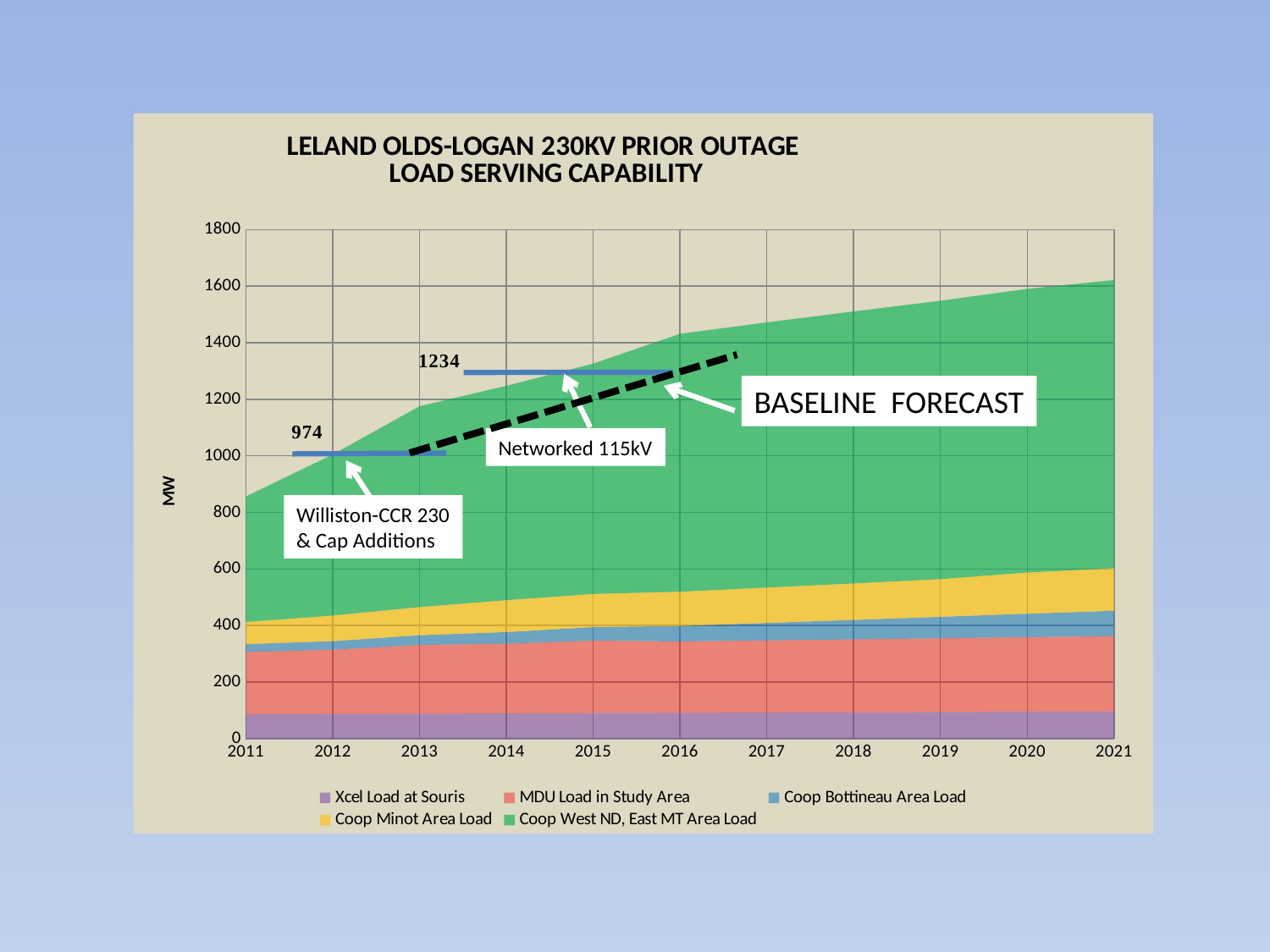
What kind of chart is shown on the slide? Area chart Does the total stacked load rise or fall from 2011 to 2021? Rise Is the total stacked load in 2021 greater or less than 1400 MW? greater What value is labelled on the Williston-CCR 230 & Cap Additions line? 974 Is the total stacked load in 2011 greater or less than 1000 MW? less How many series does the legend list? 5 What is the difference between the Networked 115kV value (1234) and the Williston-CCR 230 & Cap Additions value (974)? 260 How many years are shown along the x axis? 11 Which labelled value is larger, Networked 115kV or Williston-CCR 230 & Cap Additions? Networked 115kV Which series is shown in green? Coop West ND, East MT Area Load What is the label on the y axis? MW What value is labelled on the Networked 115kV line? 1234